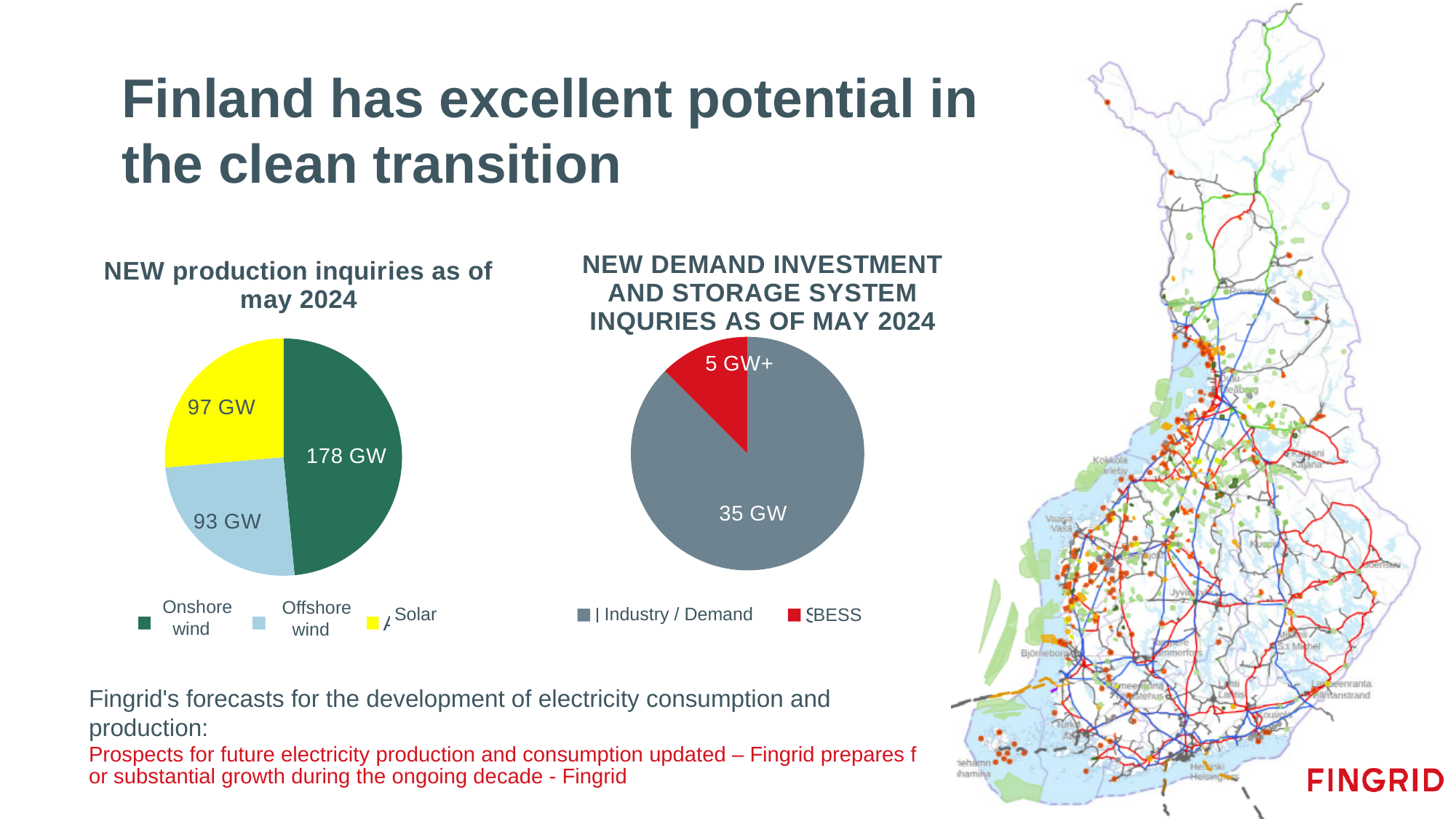
In the 'NEW production inquiries as of may 2024' chart, what is the total of all three categories? 368 GW In the 'NEW production inquiries as of may 2024' chart, what is the value for Solar? 97 GW In the 'NEW production inquiries as of may 2024' chart, how many categories are shown? 3 In the 'NEW production inquiries as of may 2024' chart, what is the value for Onshore wind? 178 GW In the 'NEW production inquiries as of may 2024' chart, what is the difference between Onshore wind and Offshore wind? 85 GW In the 'NEW DEMAND INVESTMENT AND STORAGE SYSTEM INQURIES AS OF MAY 2024' chart, which category is larger, Industry / Demand or BESS? Industry / Demand In the 'NEW production inquiries as of may 2024' chart, what is the value for Offshore wind? 93 GW In the 'NEW DEMAND INVESTMENT AND STORAGE SYSTEM INQURIES AS OF MAY 2024' chart, what is the value for Industry / Demand? 35 GW What type of chart is the 'NEW DEMAND INVESTMENT AND STORAGE SYSTEM INQURIES AS OF MAY 2024' chart? Pie chart In the 'NEW production inquiries as of may 2024' chart, which category has the smallest value? Offshore wind In the 'NEW DEMAND INVESTMENT AND STORAGE SYSTEM INQURIES AS OF MAY 2024' chart, what is the value labelled for BESS? 5 GW+ In the 'NEW production inquiries as of may 2024' chart, which category has the largest value? Onshore wind